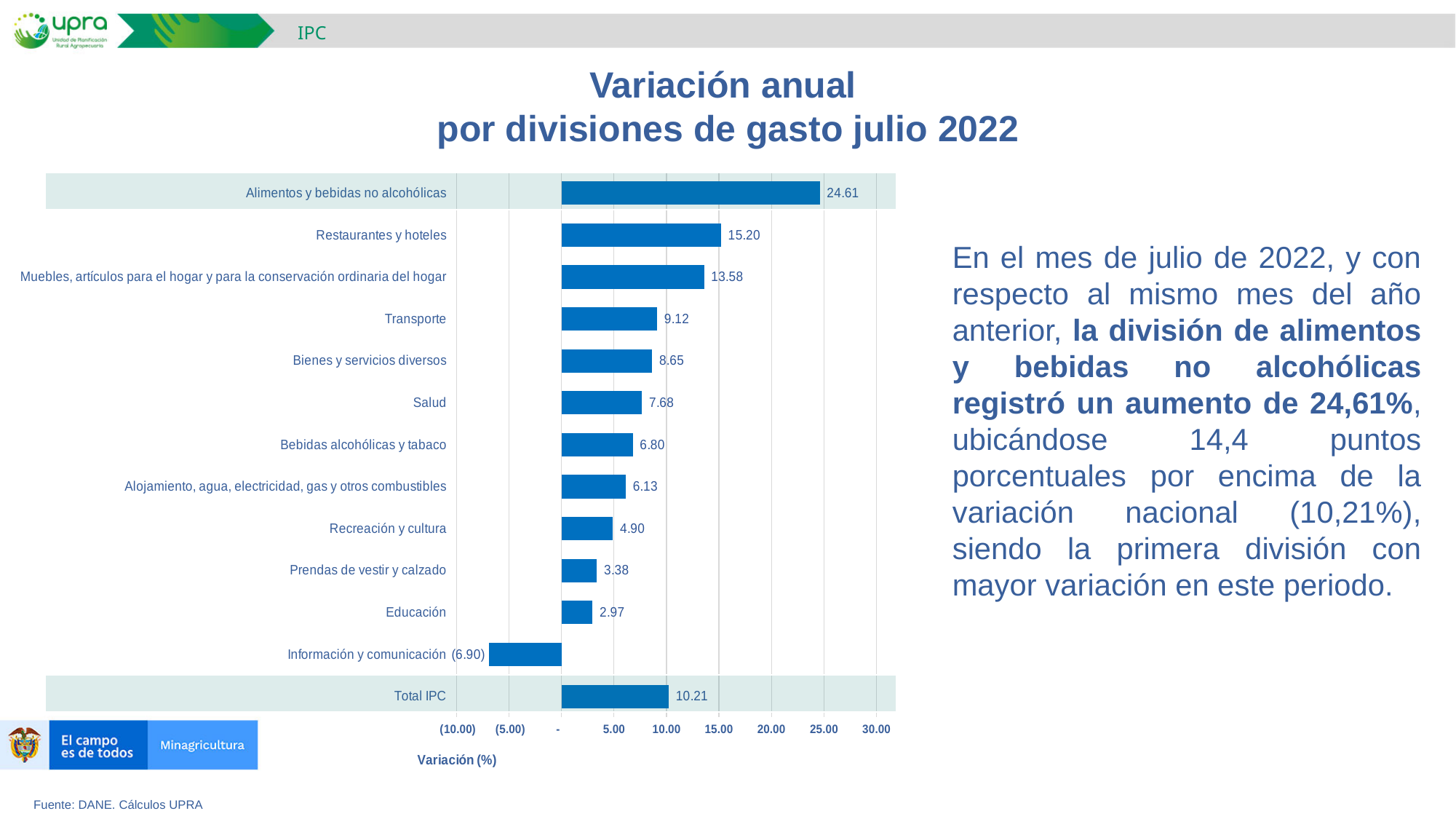
Which category has the highest value? Alimentos y bebidas no alcohólicas Which category has the lowest value? Información y comunicación How many bars does the chart show? 13 What is the value for Transporte? 9.12 What is the value for Información y comunicación? (6.90) What is the value for Total IPC? 10.21 What kind of chart is shown on the slide? bar chart What is the value for Alimentos y bebidas no alcohólicas? 24.61 What is the difference between the values for Alimentos y bebidas no alcohólicas and Restaurantes y hoteles? 9.41 Which is larger, the value for Salud or the value for Bebidas alcohólicas y tabaco? Salud Is the value for Transporte greater or less than 10.00? less What is the difference between the values for Alimentos y bebidas no alcohólicas and Total IPC? 14.40